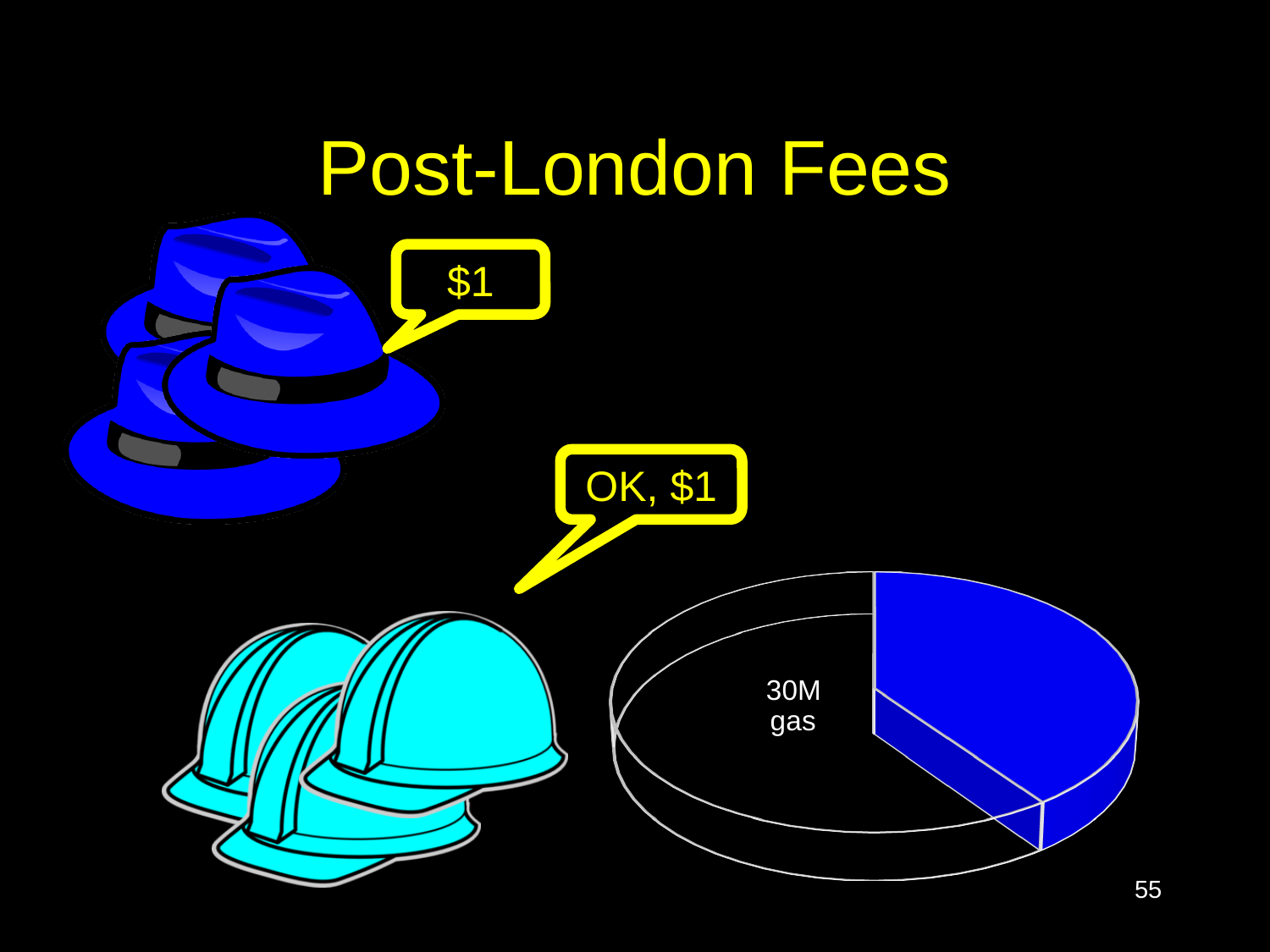
How many slices does the pie chart show? 2 What text label is printed inside the pie chart? 30M gas What kind of chart is shown on the slide? pie chart Is the blue slice of the pie chart larger or smaller than the black remainder? smaller What colour is the highlighted slice of the pie chart? blue Does the blue slice of the pie chart cover more or less than half of the pie? less